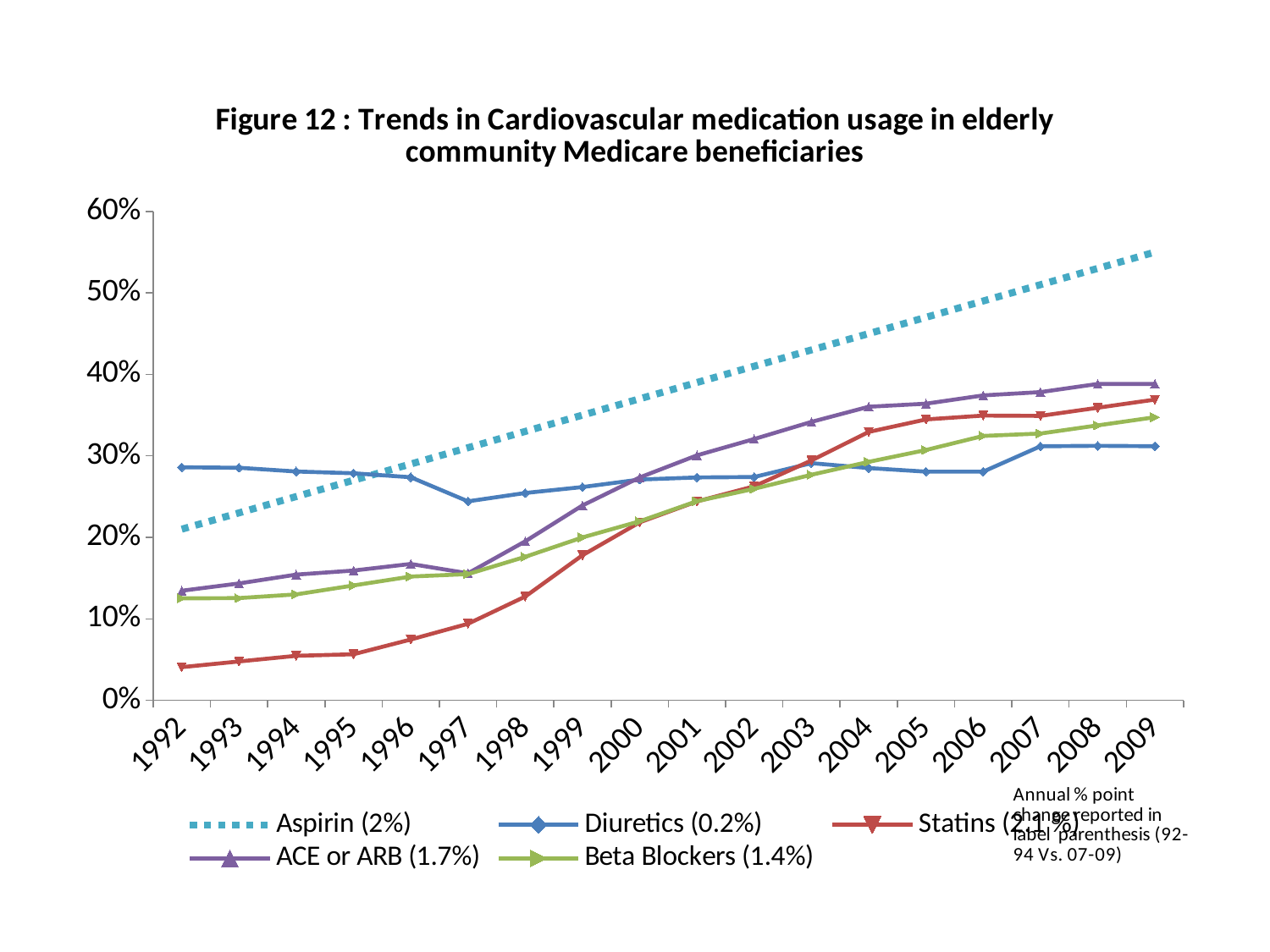
Which medication has the highest usage in 1992? Diuretics How many years are shown along the x axis? 18 What annual % point change is reported in the legend label for Statins? 2.1% What kind of chart is shown on the slide? line chart Is the value for Aspirin in 2009 greater or less than 50%? greater How many series does the legend list? 5 Which medication has the lowest usage in 1992? Statins Do the values for Statins rise or fall from 1992 to 2009? rise In 1992, which is larger: the value for Diuretics or the value for ACE or ARB? Diuretics Is the value for Diuretics in 2009 greater or less than 40%? less Which medication has the highest usage in 2009? Aspirin Is the value for Statins in 1992 greater or less than 10%? less